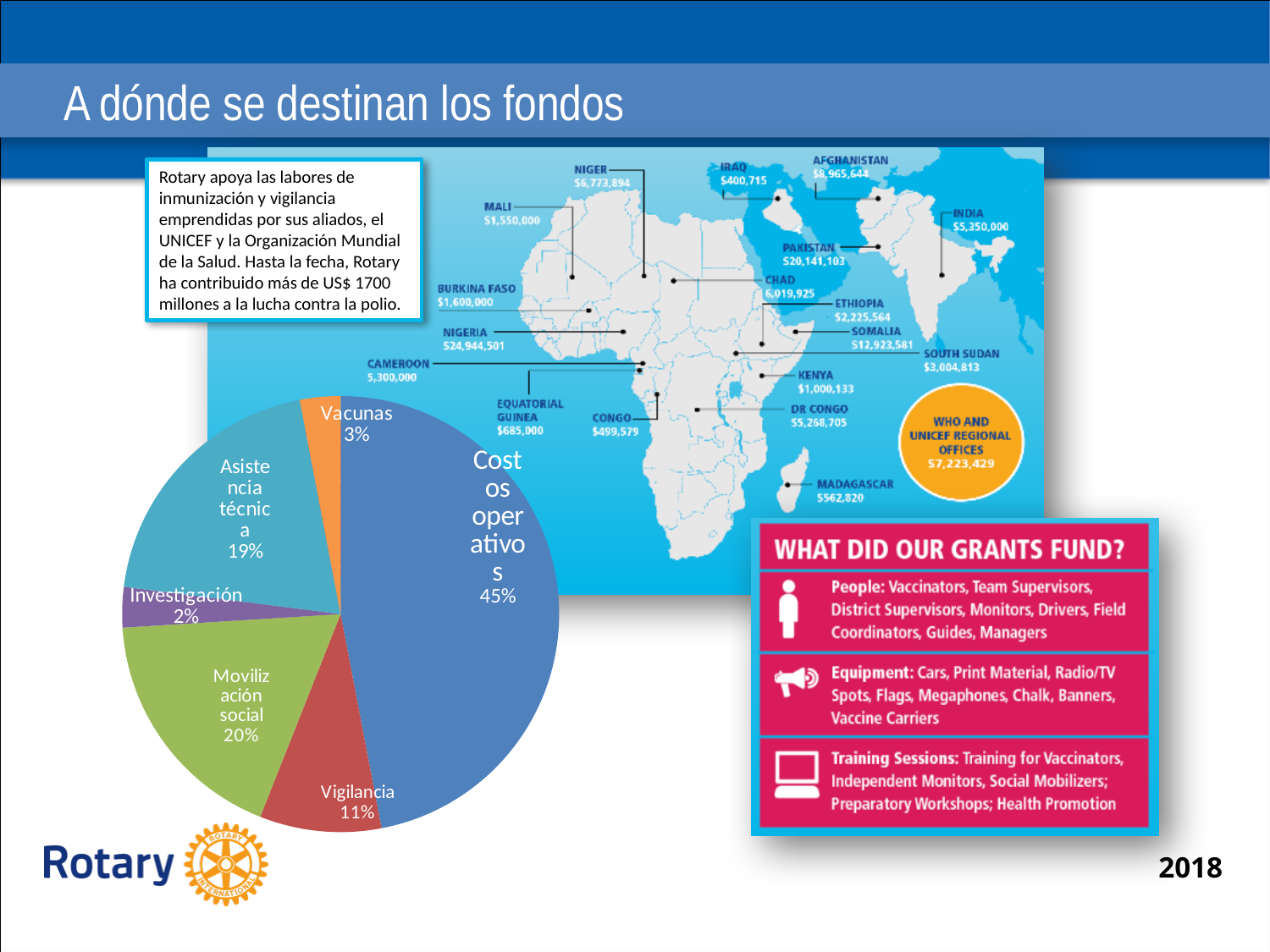
Which category has the smallest slice in the pie chart? Investigación In the pie chart, what share is labelled for Vigilancia? 11% In the pie chart, what share is labelled for Movilización social? 20% In the pie chart, which is larger: Movilización social or Vigilancia? Movilización social In the pie chart, what share is labelled for Asistencia técnica? 19% How many slices does the pie chart have? 6 Which category has the largest slice in the pie chart? Costos operativos In the pie chart, what is the difference in percentage points between Costos operativos and Asistencia técnica? 26 In the pie chart, what share is labelled for Costos operativos? 45% What kind of chart is shown on the slide? Pie chart In the pie chart, what share is labelled for Vacunas? 3% What is the combined share of Vacunas and Investigación in the pie chart? 5%